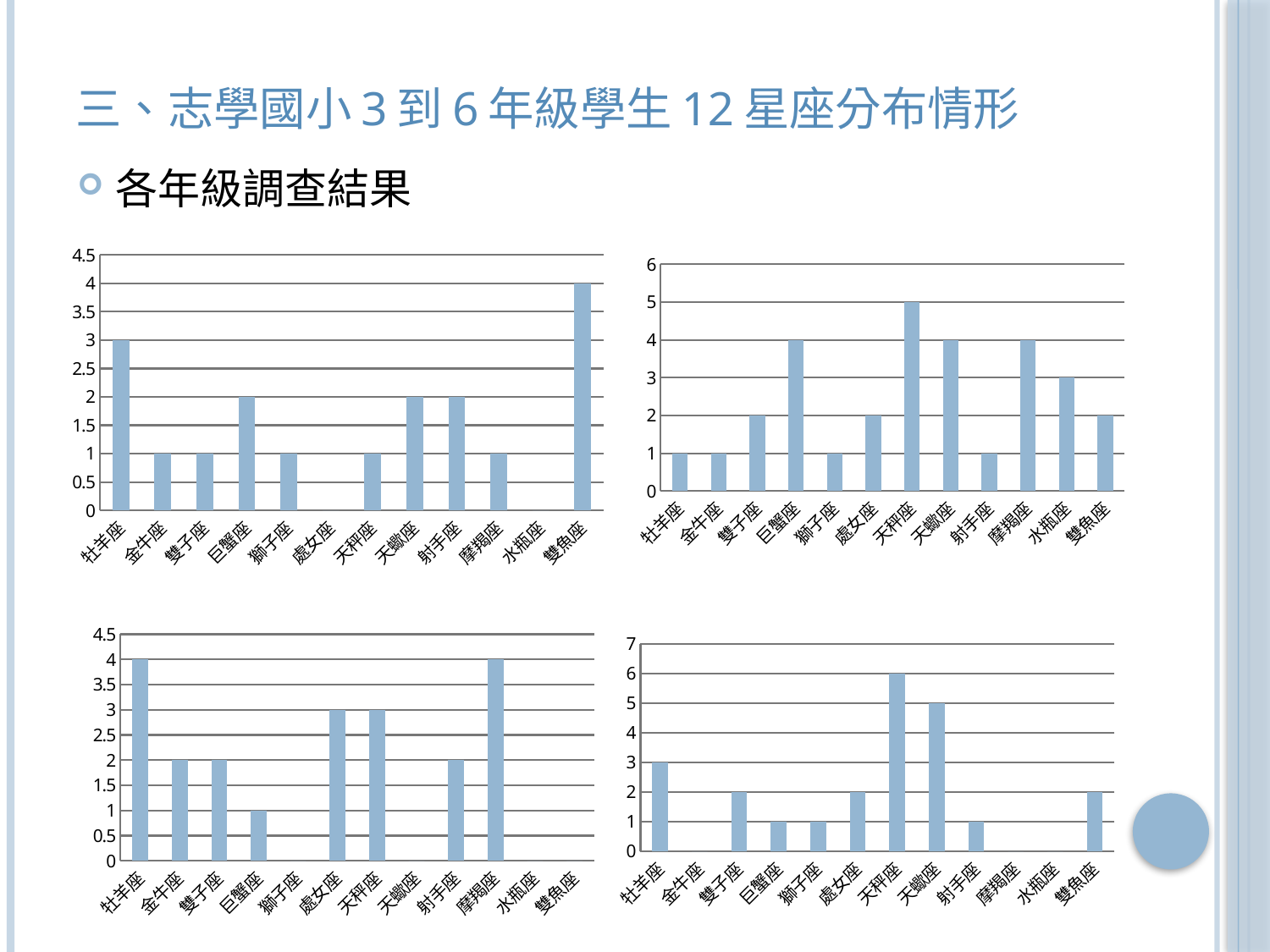
In the bottom-right chart, what is the difference between the values for 天秤座 and 天蠍座? 1 In the top-left chart, what is the value for 雙魚座? 4 In the bottom-right chart, what is the value for 天秤座? 6 In the top-right chart, what is the difference between the values for 巨蟹座 and 雙子座? 2 How many categories are shown on the x axis of the top-left chart? 12 In the bottom-right chart, which category has the highest value? 天秤座 In the top-right chart, which category has the highest value? 天秤座 In the top-right chart, what is the value for 天秤座? 5 In the bottom-left chart, what is the value for 處女座? 3 What kind of chart is the bottom-right chart? Bar chart In the top-left chart, which category has the highest value? 雙魚座 In the bottom-left chart, which is larger, the value for 牡羊座 or the value for 巨蟹座? 牡羊座